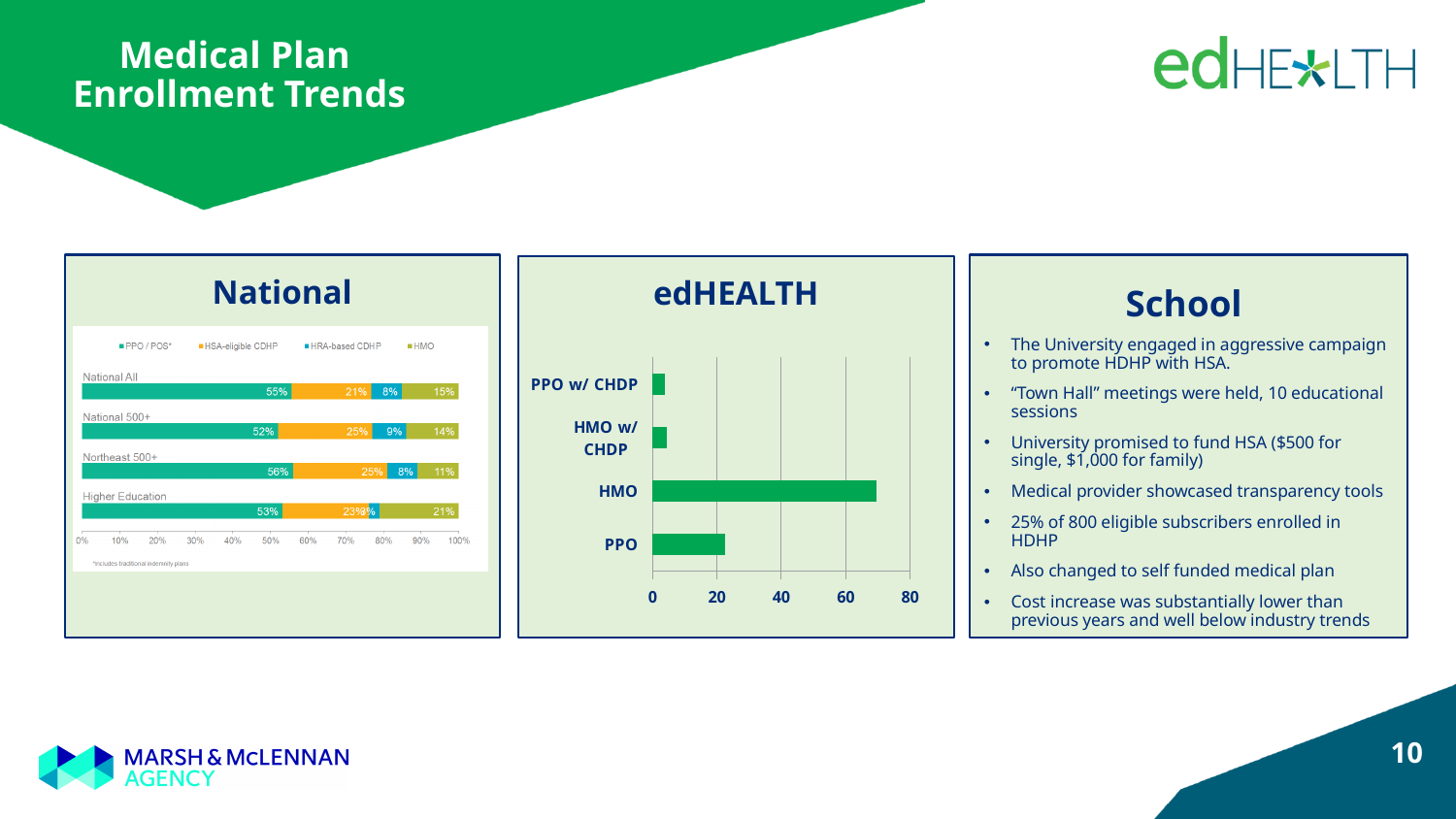
In the National chart, which category has the highest PPO / POS* share? Northeast 500+ In the National chart, what is the HRA-based CDHP value for Northeast 500+? 8% In the National chart, how many categories are shown? 4 In the National chart, how many series does the legend list? 4 In the edHEALTH chart, is the value for PPO w/ CHDP greater or less than 20? less In the National chart, what is the HMO value for Higher Education? 21% In the National chart, what is the PPO / POS* value for National All? 55% What kind of chart is the edHEALTH chart? Bar chart In the edHEALTH chart, which plan has the highest value? HMO In the edHEALTH chart, is the value for HMO greater or less than 60? greater In the National chart, what is the difference between the HMO values for National All and Northeast 500+? 4% In the National chart, what is the HSA-eligible CDHP value for National 500+? 25%